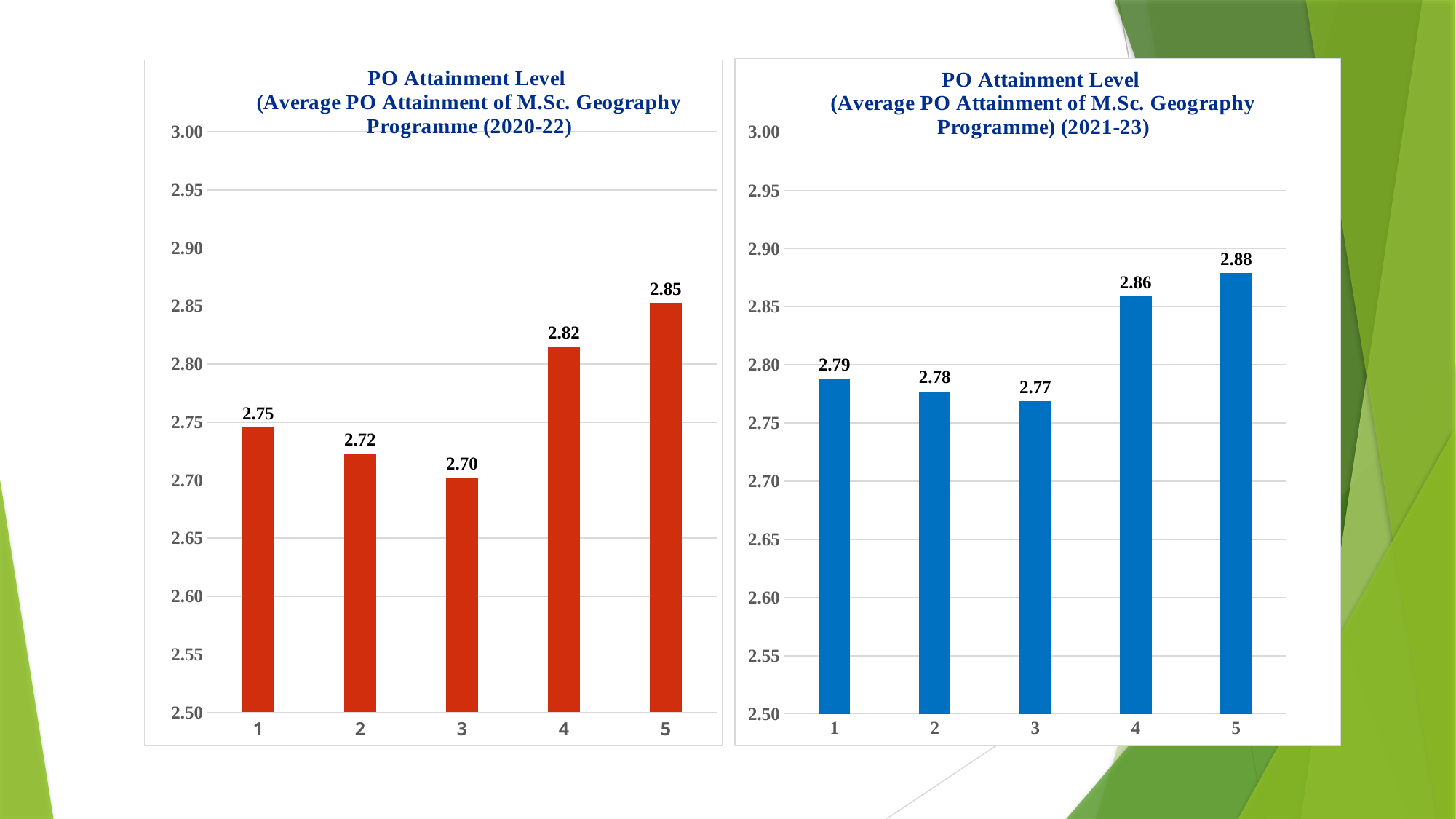
In the left chart (2020-22), which category has the highest value? 5 In the left chart (2020-22), which is larger, the value for category 1 or category 4? 4 In the left chart (2020-22), what is the value for category 3? 2.70 In the left chart (2020-22), what is the difference between the values for category 5 and category 3? 0.15 What kind of chart is the right chart (2021-23)? bar chart In the right chart (2021-23), what is the difference between the values for category 5 and category 1? 0.09 In the right chart (2021-23), what is the value for category 4? 2.86 In the right chart (2021-23), is the value for category 5 greater or less than 2.85? greater In the right chart (2021-23), which category has the lowest value? 3 How many categories are shown in the left chart (2020-22)? 5 In the left chart (2020-22), do the values rise or fall from category 3 to category 5? rise What colour are the bars in the right chart (2021-23)? blue